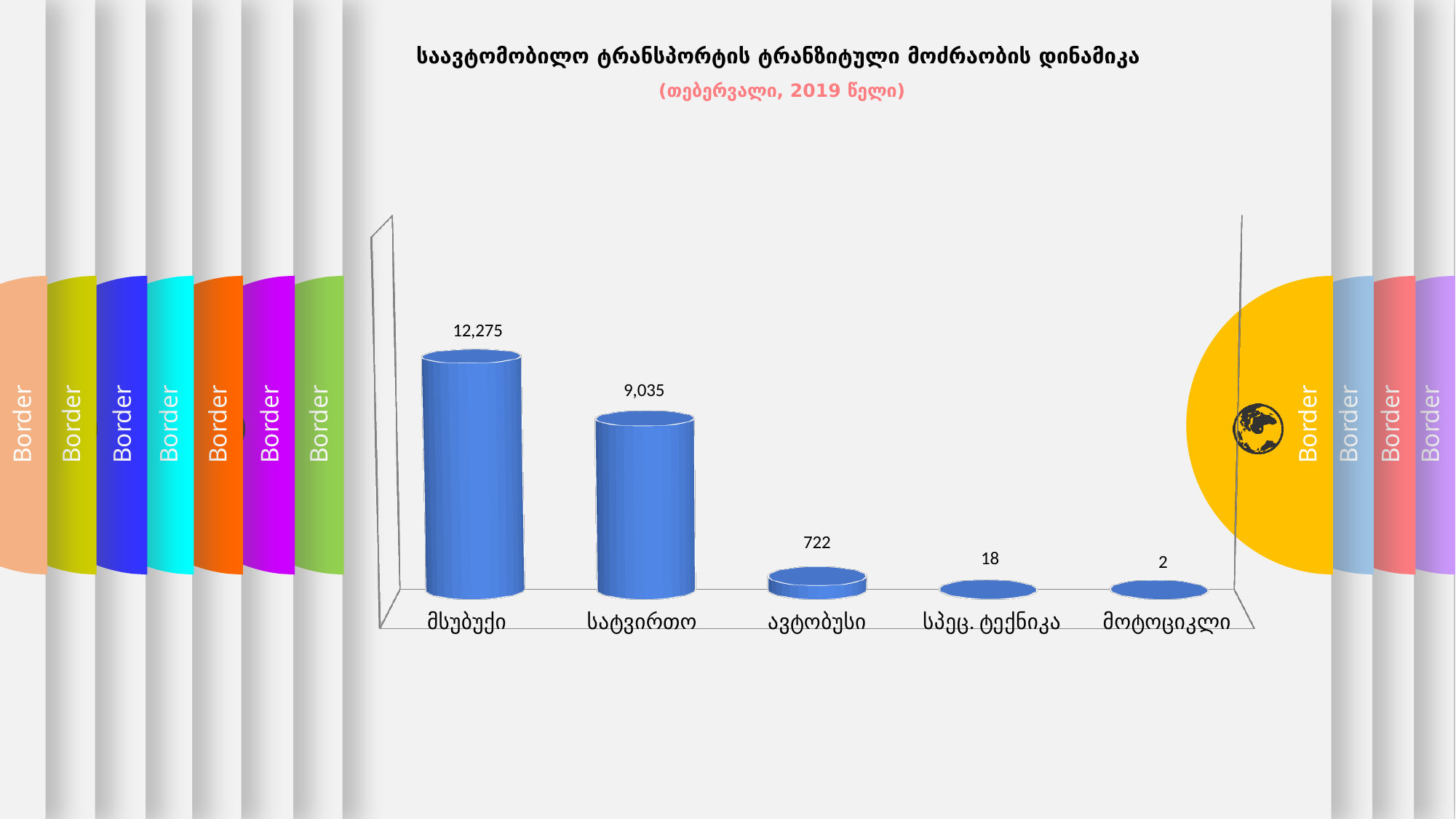
What is the value for მსუბუქი? 12,275 What is the value for სპეც. ტექნიკა? 18 What is the value for ავტობუსი? 722 What kind of chart is shown on the slide? bar chart What is the difference between the values for მსუბუქი and სატვირთო? 3,240 Which category has the lowest value? მოტოციკლი Which is larger, the value for ავტობუსი or the value for სპეც. ტექნიკა? ავტობუსი Which category has the highest value? მსუბუქი What is the value for სატვირთო? 9,035 What period is given in the chart's subtitle? თებერვალი, 2019 წელი How many categories are shown in the chart? 5 What is the value for მოტოციკლი? 2